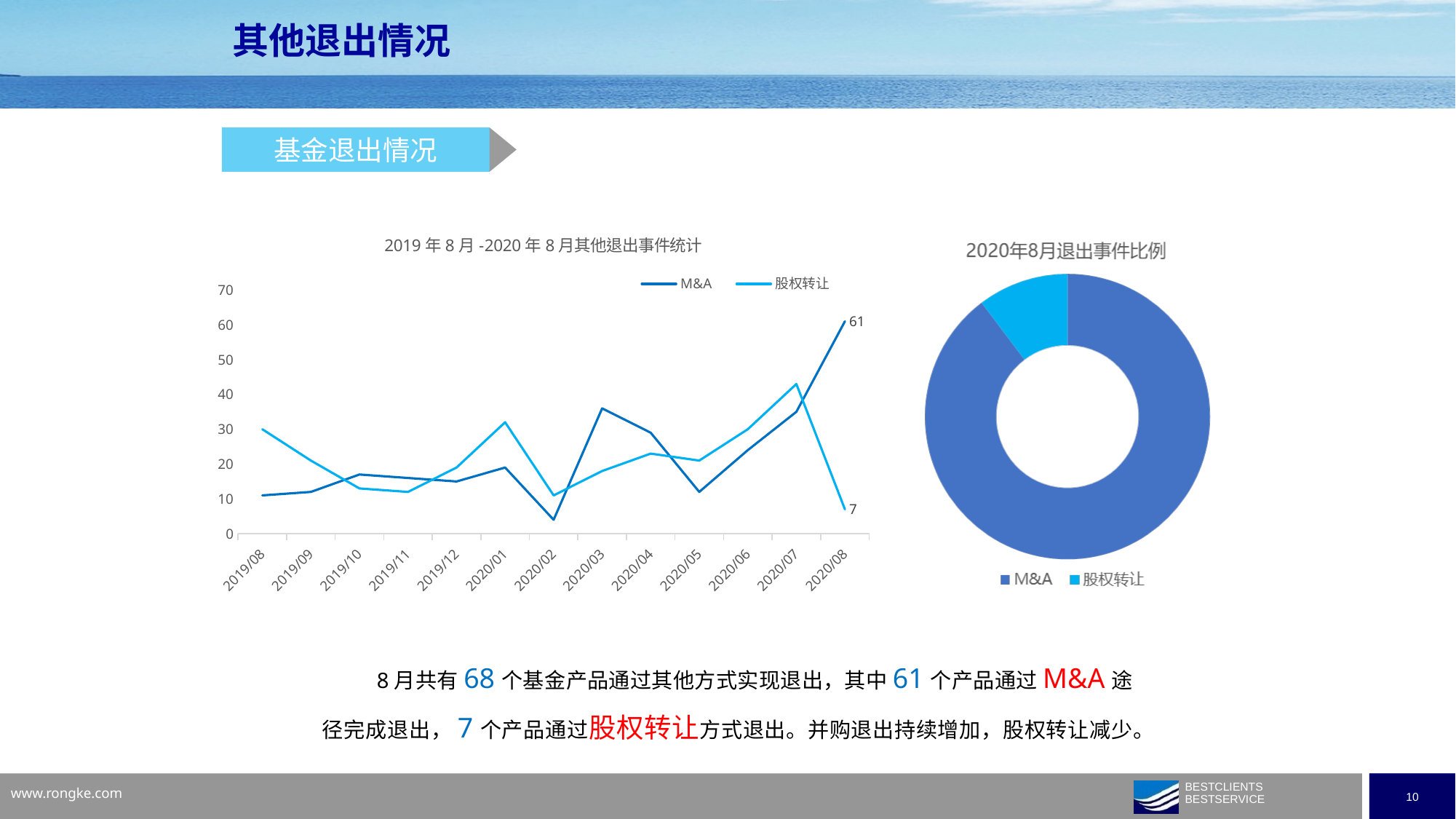
In the left line chart, in which month is the M&A value highest? 2020/08 In the left line chart, what is the value of M&A for 2020/08? 61 In the left line chart, does the M&A line rise or fall from 2020/05 to 2020/08? Rise In the left line chart, what is the value of 股权转让 for 2020/08? 7 In the right doughnut chart, which slice is larger, M&A or 股权转让? M&A What kind of chart is the right chart titled "2020年8月退出事件比例"? Doughnut (pie) chart How many series does the legend of the left line chart list? 2 In the left line chart, in which month is the M&A value lowest? 2020/02 What kind of chart is the left chart titled "2019 年 8 月 -2020 年 8 月其他退出事件统计"? Line chart How many months are shown on the x axis of the left line chart? 13 In the left line chart, what is the difference between the M&A value and the 股权转让 value for 2020/08? 54 In the left line chart, is the M&A value for 2020/03 greater or less than 30? greater